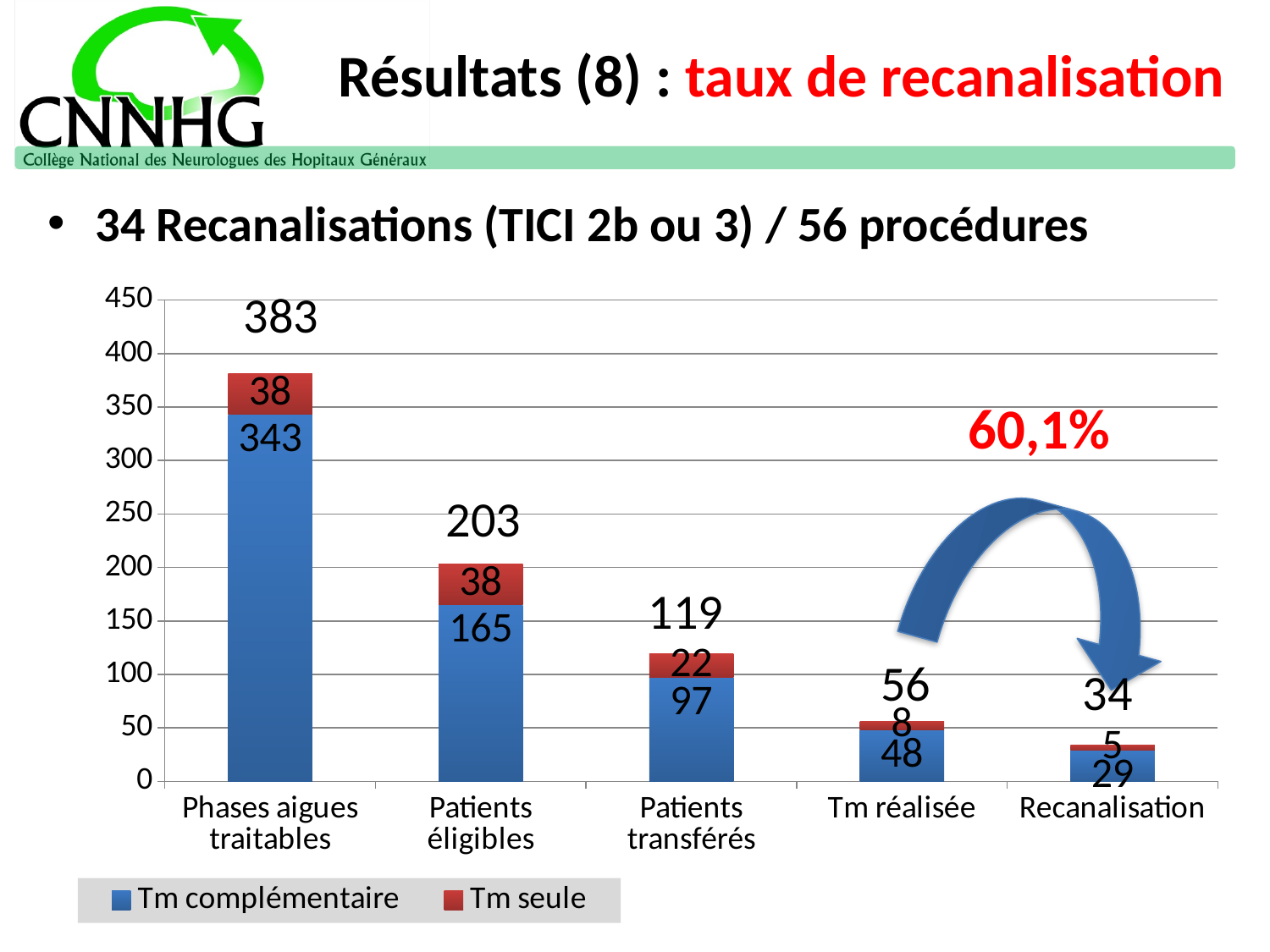
What is the value of Tm complémentaire for Tm réalisée? 48 What is the difference between the Tm complémentaire values for Patients éligibles and Patients transférés? 68 Which category has the highest total bar? Phases aigues traitables What is the value of Tm seule for Patients transférés? 22 Which is larger: the Tm seule value for Tm réalisée or for Recanalisation? Tm réalisée What type of chart is shown on the slide? stacked bar chart What is the total of the stacked bar for Patients éligibles? 203 What is the total of the stacked bar for Recanalisation? 34 What is the value of Tm complémentaire for Phases aigues traitables? 343 How many series does the chart legend list? 2 Which category has the lowest total bar? Recanalisation How many categories are shown on the x axis of the chart? 5